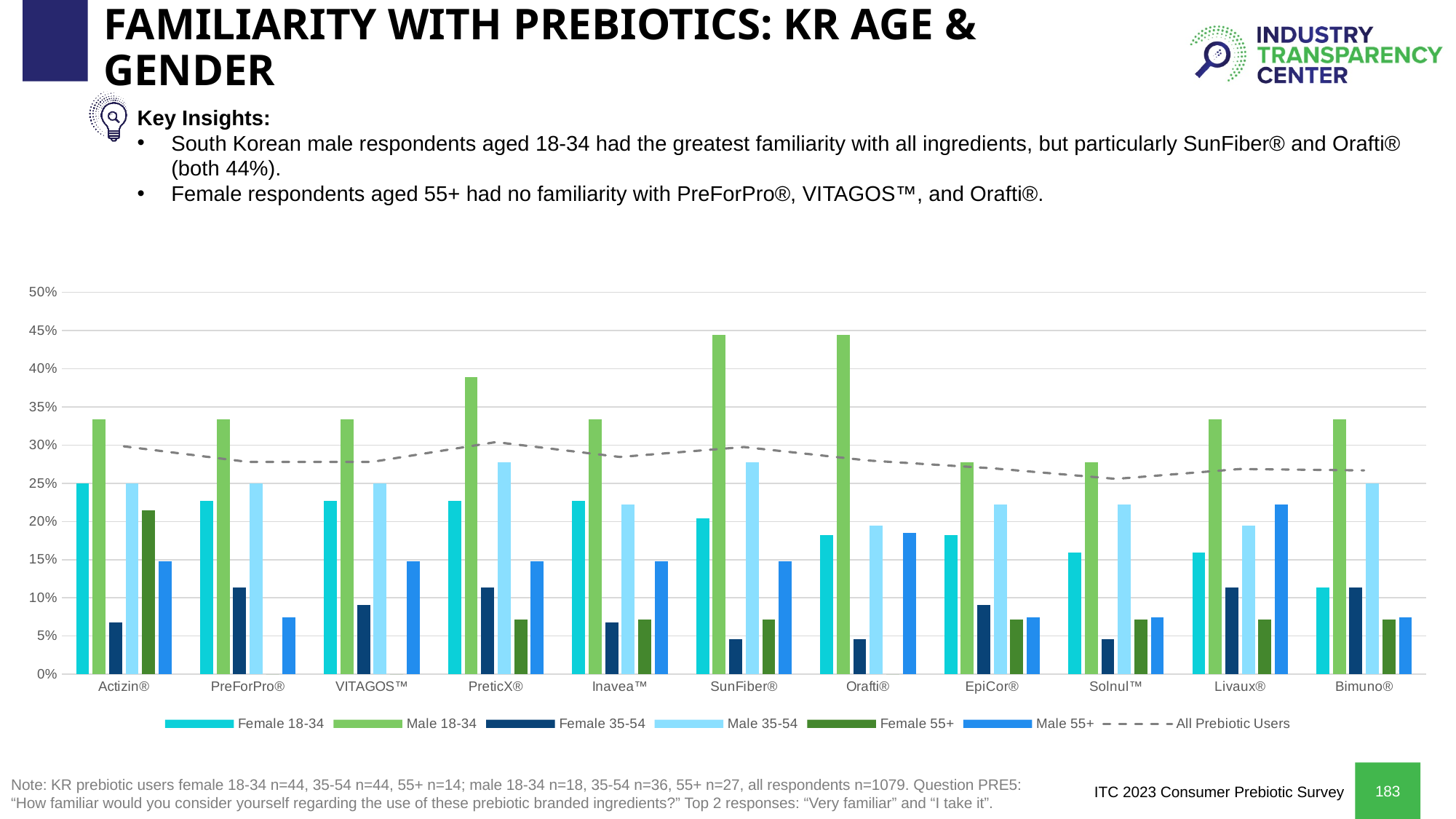
Is the Male 18-34 value for PreticX® greater or less than 35%? greater Is the Female 35-54 value for Actizin® greater or less than 10%? less Which is larger: the Male 55+ value for Livaux® or the Male 55+ value for Solnul™? Livaux® How many entries does the chart's legend list? 7 Is the Male 55+ value for Livaux® greater or less than 20%? greater Which series has the tallest bar for SunFiber®? Male 18-34 What does the dashed line in the chart represent, according to the legend? All Prebiotic Users For Actizin®, which is larger: the Male 18-34 value or the Female 18-34 value? Male 18-34 What kind of chart is shown on the slide? combination bar and line chart Which series has the tallest bar for PreticX®? Male 18-34 How many prebiotic ingredients are shown along the x axis of the chart? 11